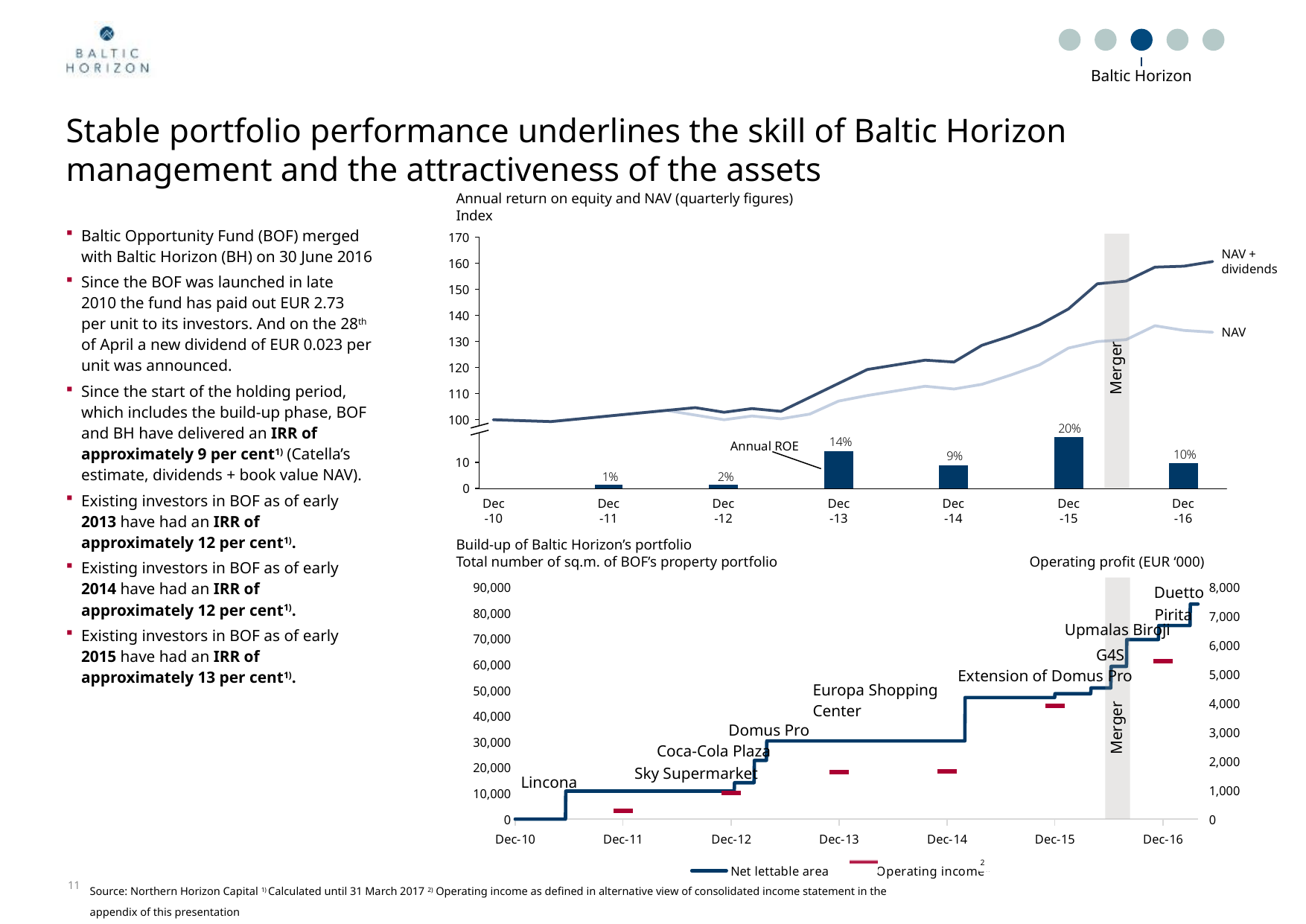
In the 'Annual return on equity and NAV' chart, which labelled year has the lowest Annual ROE? Dec-11 In the 'Annual return on equity and NAV' chart, which year has the highest Annual ROE? Dec-15 In the 'Annual return on equity and NAV' chart, what is the difference between the Annual ROE for Dec-15 and Dec-14? 11% In the 'Annual return on equity and NAV' chart, what is the Annual ROE for Dec-13? 14% In the 'Annual return on equity and NAV' chart, what is the Annual ROE for Dec-15? 20% In the 'Annual return on equity and NAV' chart, is the NAV + dividends index at Dec-16 greater or less than 150? greater In the 'Build-up of Baltic Horizon's portfolio' chart, what does the shaded vertical band between Dec-15 and Dec-16 mark? Merger In the 'Annual return on equity and NAV' chart, which has the higher Annual ROE, Dec-13 or Dec-16? Dec-13 In the 'Build-up of Baltic Horizon's portfolio' chart, how many series does the legend list? 2 In the 'Annual return on equity and NAV' chart, how many year categories are shown on the x axis? 7 In the 'Build-up of Baltic Horizon's portfolio' chart, does the Net lettable area rise or fall from Dec-10 to Dec-16? rises In the 'Annual return on equity and NAV' chart, is the NAV index at Dec-16 greater or less than 140? less